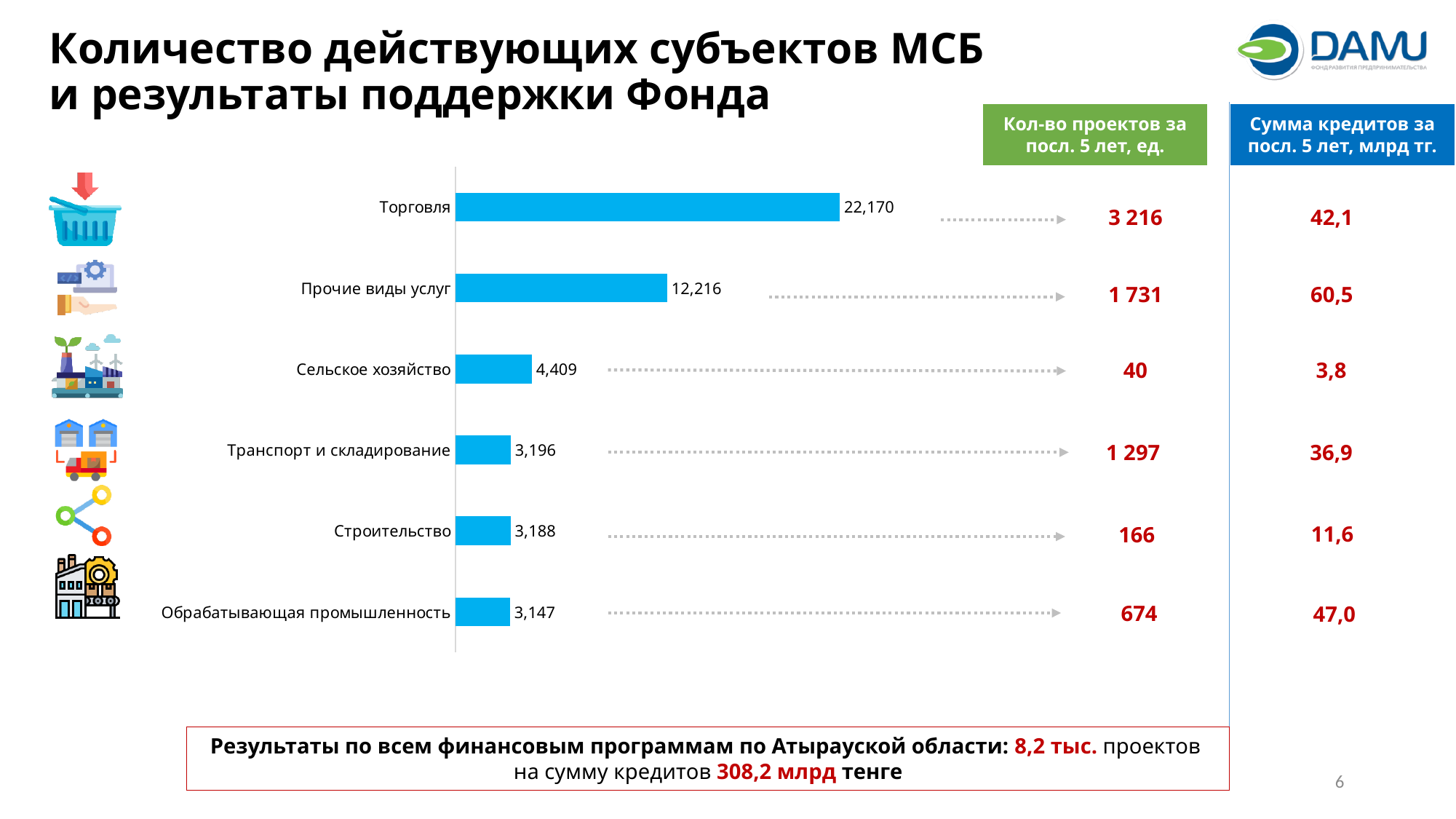
What value is shown for Обрабатывающая промышленность in the bar chart? 3,147 What kind of chart is shown on the slide? Bar chart How many categories are shown in the bar chart? 6 What value is shown for Сельское хозяйство in the bar chart? 4,409 What colour are the bars in the chart? Blue Which category has the highest value in the bar chart? Торговля Which category has the lowest value in the bar chart? Обрабатывающая промышленность What is the difference between the values for Торговля and Прочие виды услуг? 9,954 What is the difference between the values for Транспорт и складирование and Строительство? 8 What value is shown for Прочие виды услуг in the bar chart? 12,216 Which is larger, the value for Сельское хозяйство or the value for Строительство? Сельское хозяйство What value is shown for Торговля in the bar chart? 22,170